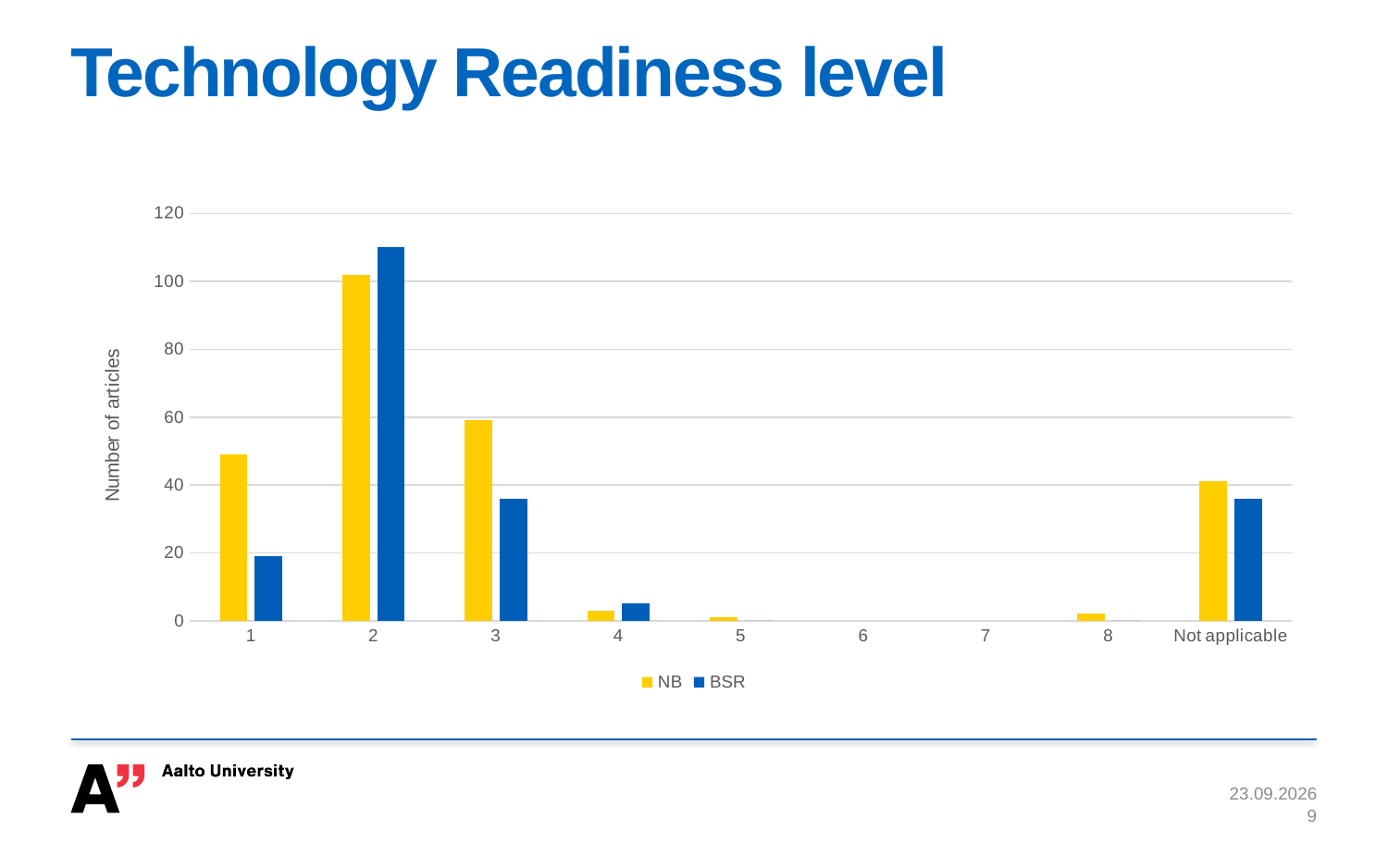
Is the BSR value for category 2 greater or less than 100? greater How many categories are shown on the x axis? 9 Which category has the highest BSR value? 2 Is the BSR value for category 3 greater or less than 40? less Is the NB value for category 1 greater or less than 60? less What kind of chart is shown on the slide? bar chart For category 1, which series has the larger value, NB or BSR? NB What is the label of the y axis? Number of articles Which category has the highest NB value? 2 For category 2, which series has the larger value, NB or BSR? BSR How many series does the legend list? 2